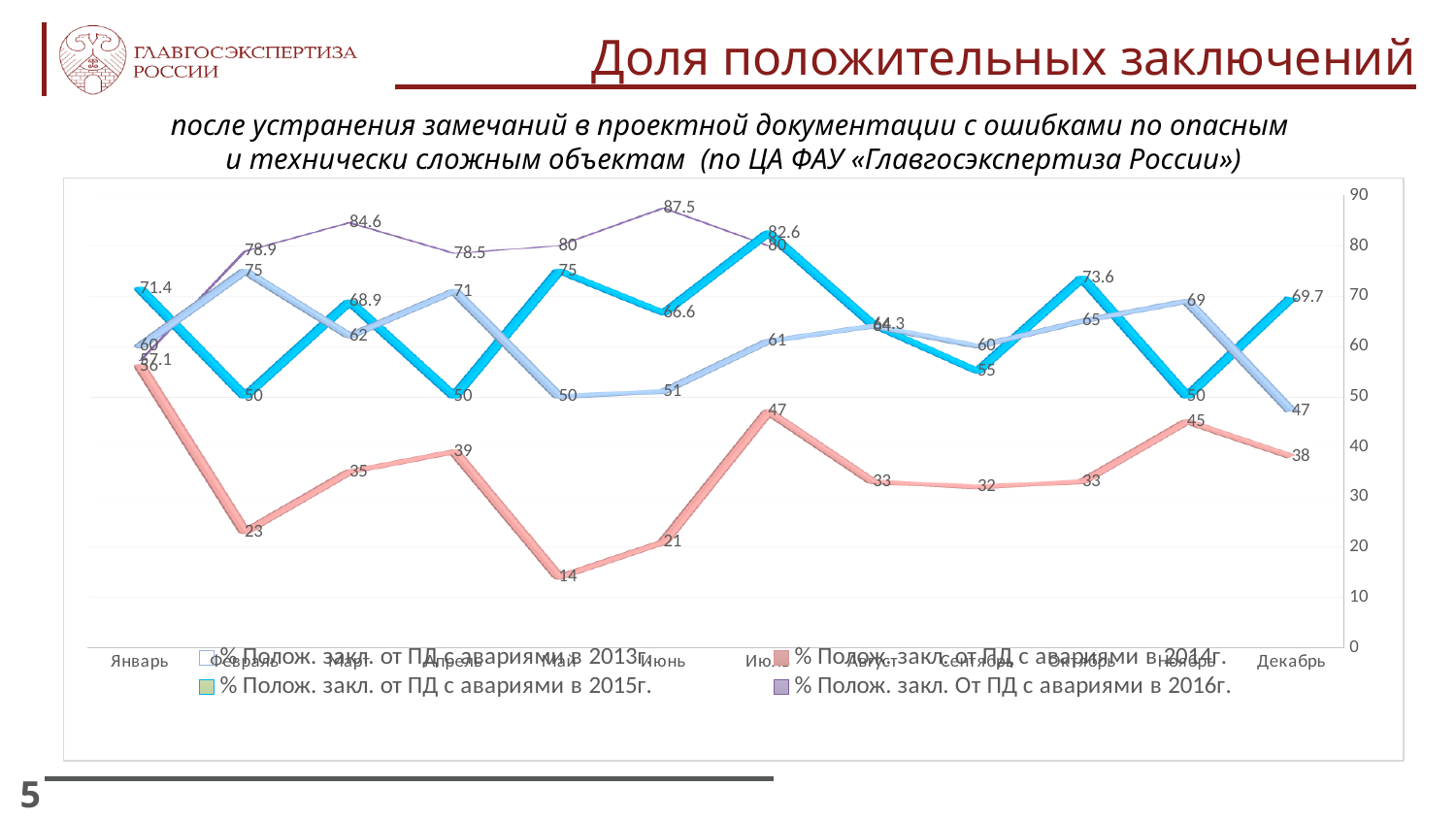
What is the difference between the Июль and Июнь values in the series "% Полож. закл. от ПД с авариями в 2014г."? 26 What is the value for Июнь in the series "% Полож. закл. От ПД с авариями в 2016г."? 87.5 What is the value for Январь in the series "% Полож. закл. от ПД с авариями в 2013г."? 60 How many series does the legend list? 4 Is the Сентябрь value in the series "% Полож. закл. от ПД с авариями в 2014г." greater or less than 40? less What is the title of the slide containing the chart? Доля положительных заключений What kind of chart is shown on the slide? line chart In the series "% Полож. закл. от ПД с авариями в 2014г.", which is larger: the value for Март or the value for Апрель? Апрель In which month is the series "% Полож. закл. от ПД с авариями в 2014г." highest? Январь What is the value for Май in the series "% Полож. закл. от ПД с авариями в 2014г."? 14 How many months are shown along the x axis? 12 In which month is the series "% Полож. закл. от ПД с авариями в 2014г." lowest? Май